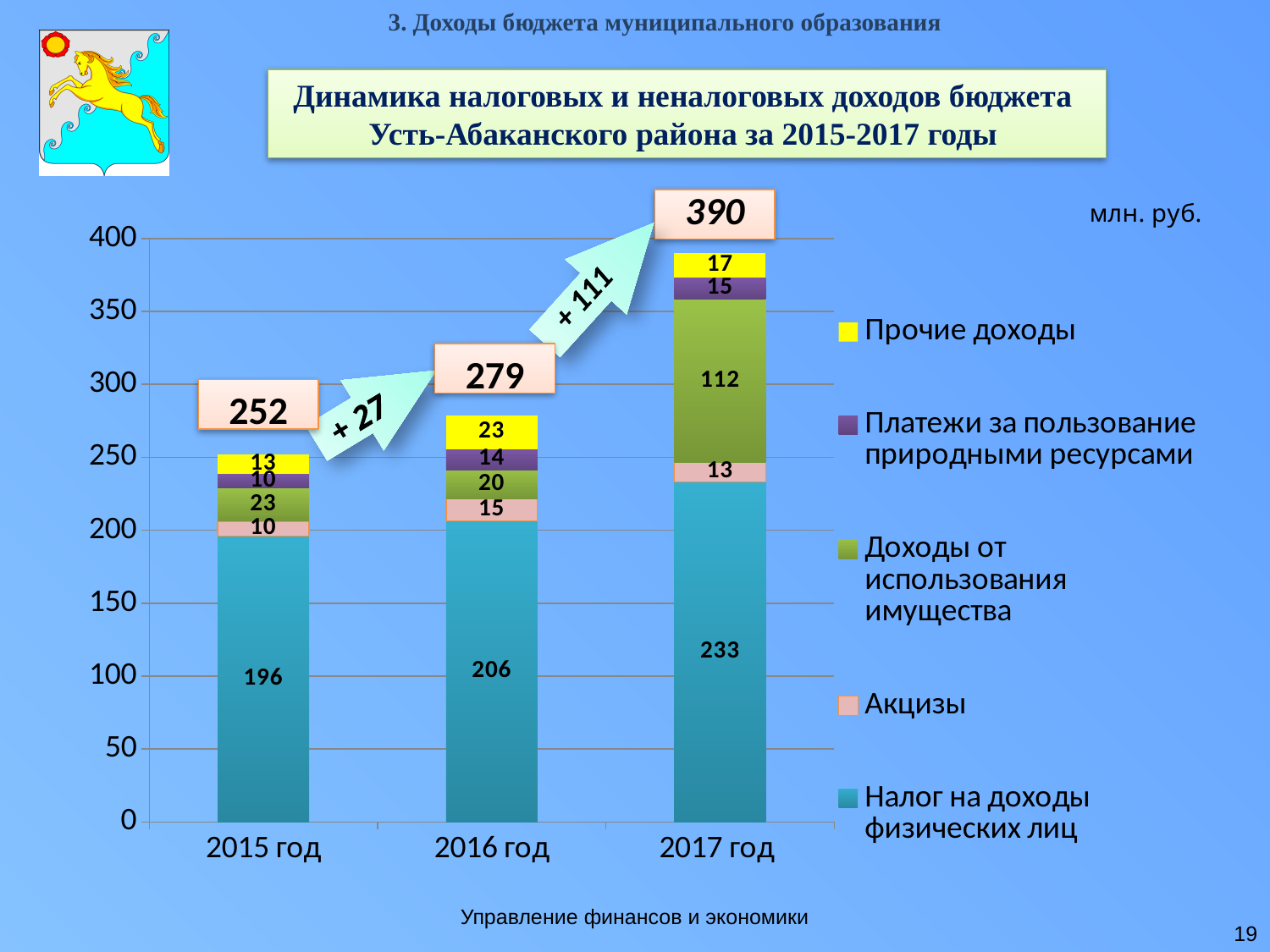
What is the total labelled above the stacked bar for 2017 год? 390 Which year has the highest total income? 2017 год What is the difference between Налог на доходы физических лиц in 2017 год and 2015 год? 37 Which is larger: Доходы от использования имущества in 2016 год or in 2017 год? 2017 год What is the value of Доходы от использования имущества for 2017 год? 112 How many series does the legend list? 5 What kind of chart is shown on the slide? Stacked bar chart What is the total labelled above the stacked bar for 2016 год? 279 What is the value of Налог на доходы физических лиц for 2017 год? 233 What is the value of Акцизы for 2016 год? 15 Which year has the lowest value for Налог на доходы физических лиц? 2015 год What is the value of Прочие доходы for 2015 год? 13